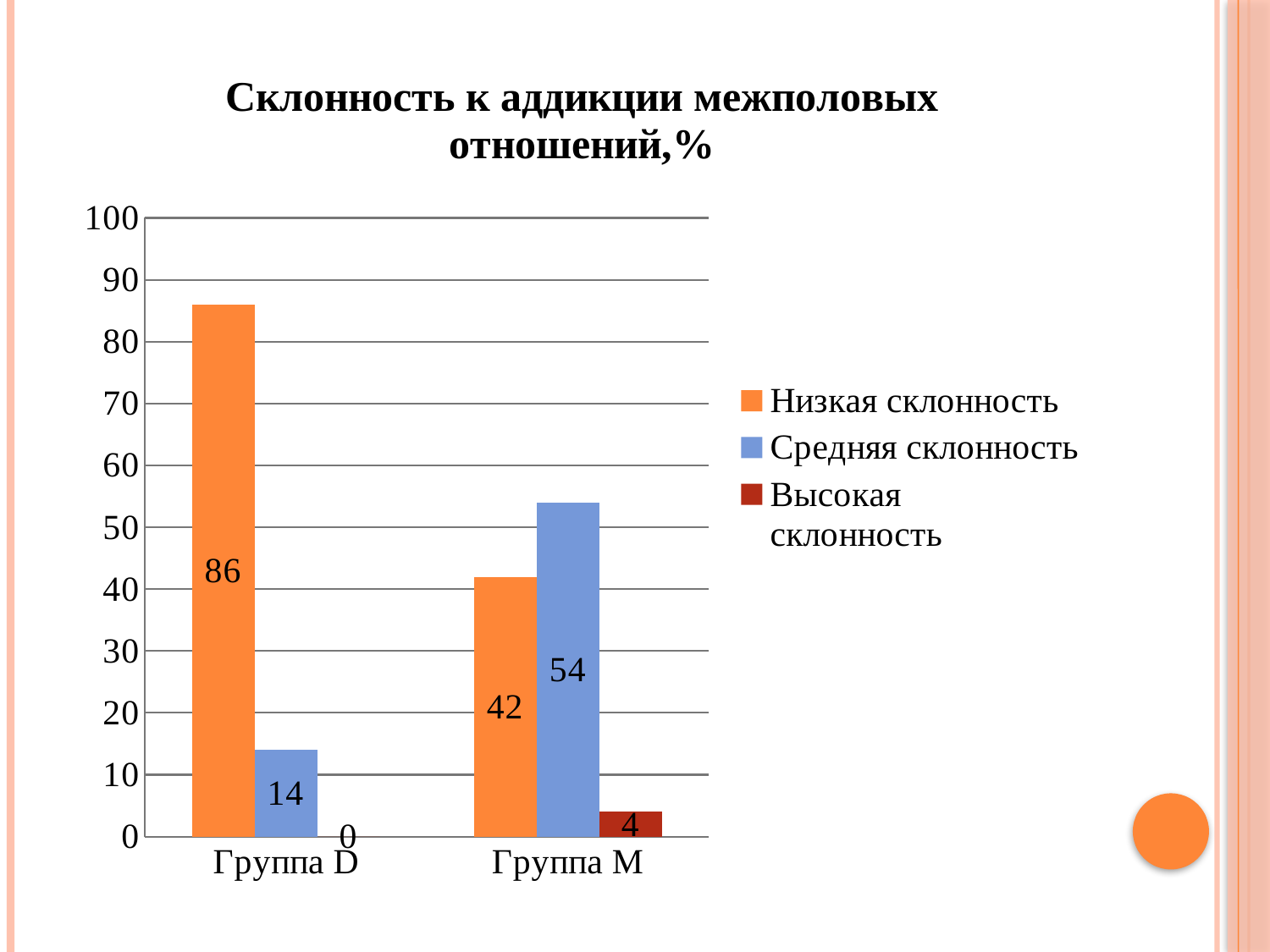
What is the difference between Низкая склонность for Группа D and Низкая склонность for Группа M? 44 How many groups are shown on the x axis? 2 What is the value of Высокая склонность for Группа D? 0 What is the value of Низкая склонность for Группа D? 86 Which series has the lowest value for Группа D? Высокая склонность Which is larger: Средняя склонность for Группа D or Средняя склонность for Группа M? Группа M How many series does the legend list? 3 What is the title of the chart? Склонность к аддикции межполовых отношений,% What is the value of Средняя склонность for Группа M? 54 What kind of chart is shown on the slide? Bar chart What is the value of Высокая склонность for Группа M? 4 Which series has the highest value for Группа M? Средняя склонность